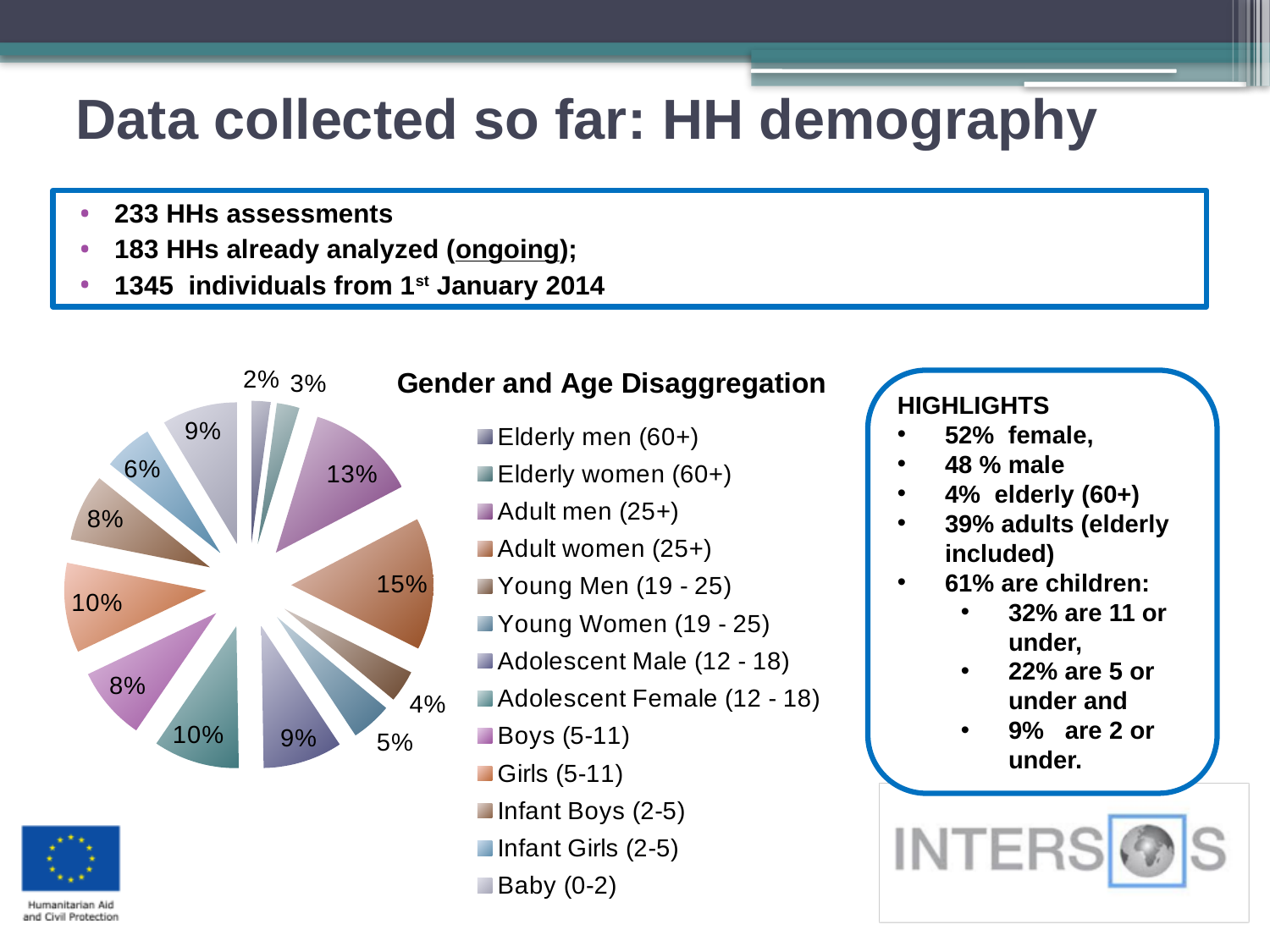
What share of the pie is Adult men (25+)? 13% How many categories does the chart's legend list? 13 Which category has the smallest slice of the pie? Elderly men (60+) What share of the pie is Elderly women (60+)? 3% What is the combined share of Elderly men (60+) and Elderly women (60+)? 5% Which category has the largest slice of the pie? Adult women (25+) What share of the pie is Adult women (25+)? 15% What is the difference in percentage points between Adult women (25+) and Adult men (25+)? 2% Which is larger, the slice for Adult men (25+) or the slice for Infant Girls (2-5)? Adult men (25+) What is the title of the chart? Gender and Age Disaggregation What kind of chart is shown on the slide? pie chart